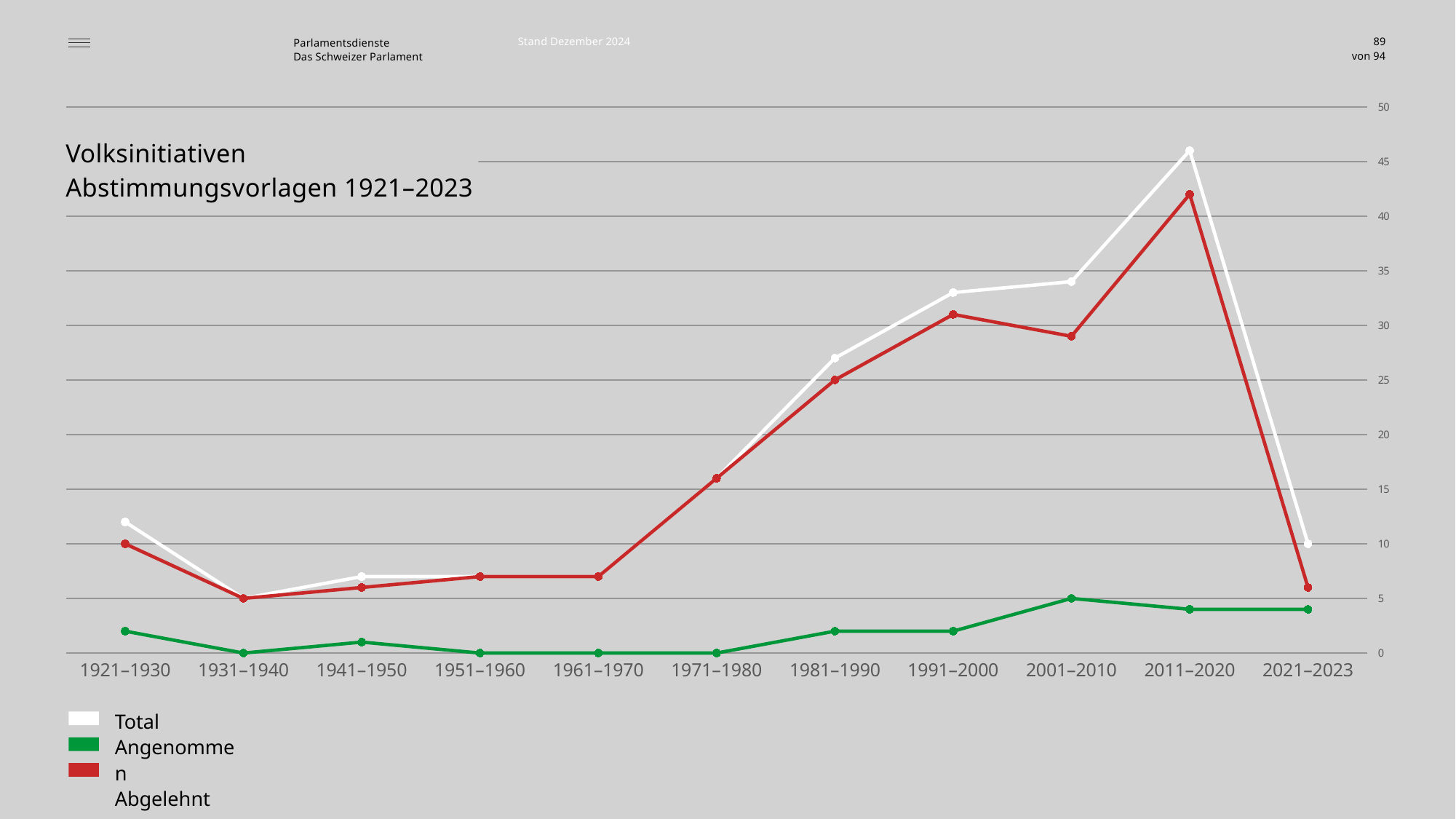
What is the value of Abgelehnt for 1981–1990? 25 What kind of chart is shown on the slide? line chart What is the value of Abgelehnt for 1921–1930? 10 Is the value of Abgelehnt for 2011–2020 greater or less than 40? greater In which period is the Total value lowest? 1931–1940 What is the value of Total for 2021–2023? 10 What is the value of Angenommen for 1971–1980? 0 How many periods are shown on the x axis? 11 In which period is the Total value highest? 2011–2020 Which is larger in 1981–1990, Abgelehnt or Angenommen? Abgelehnt How many series does the legend list? 3 Does the Total line rise or fall from 1961–1970 to 2011–2020? rise